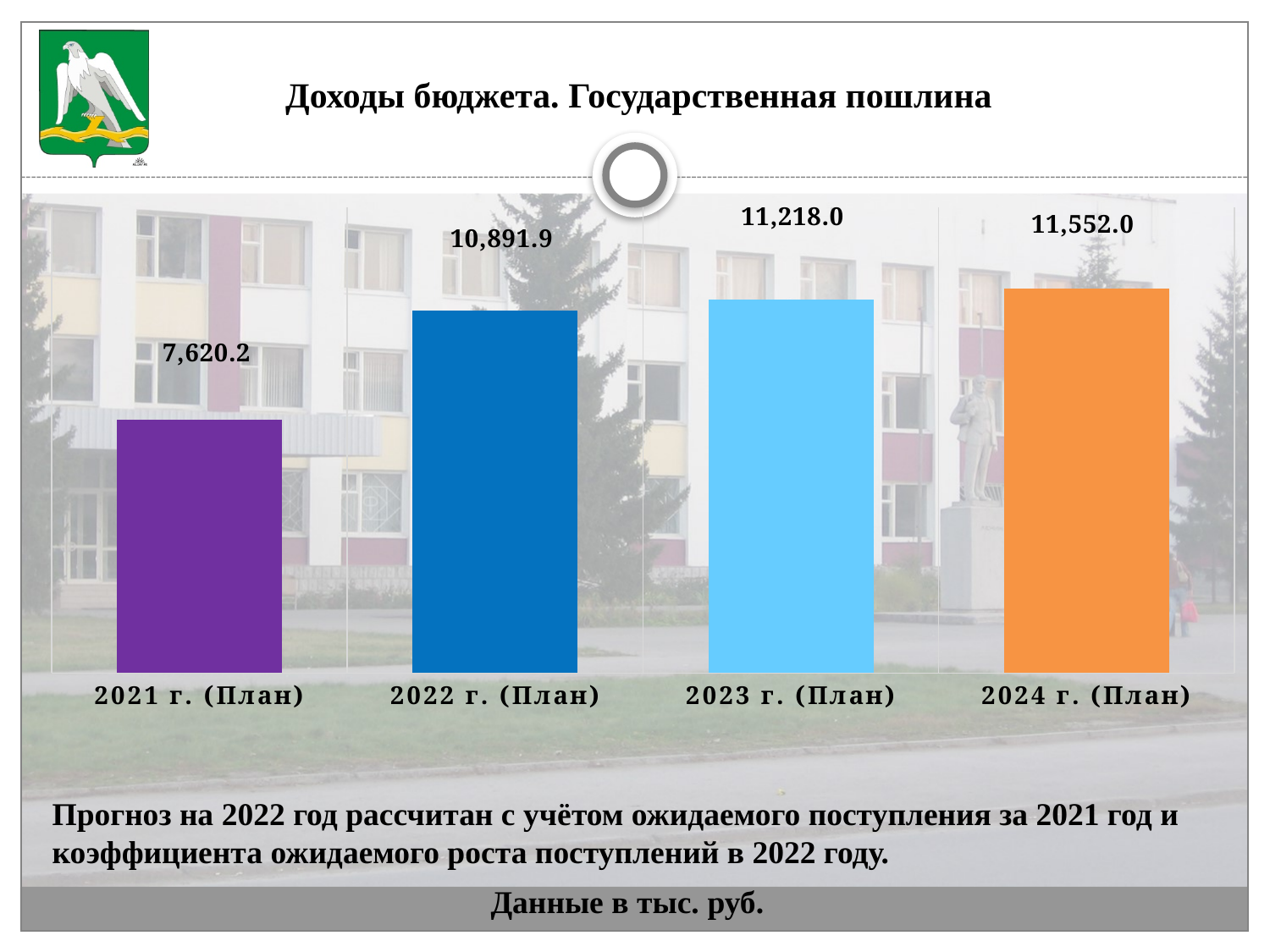
How many categories are shown in the chart? 4 What is the difference between the values for 2024 г. (План) and 2023 г. (План)? 334.0 Which category has the lowest value? 2021 г. (План) Which category has the highest value? 2024 г. (План) What is the value for 2024 г. (План)? 11,552.0 What is the value for 2022 г. (План)? 10,891.9 What kind of chart is shown on the slide? bar chart Do the values rise or fall from 2021 г. (План) to 2024 г. (План)? rise Which is larger, the value for 2022 г. (План) or 2023 г. (План)? 2023 г. (План) What is the value for 2021 г. (План)? 7,620.2 What is the difference between the values for 2022 г. (План) and 2021 г. (План)? 3,271.7 What is the value for 2023 г. (План)? 11,218.0